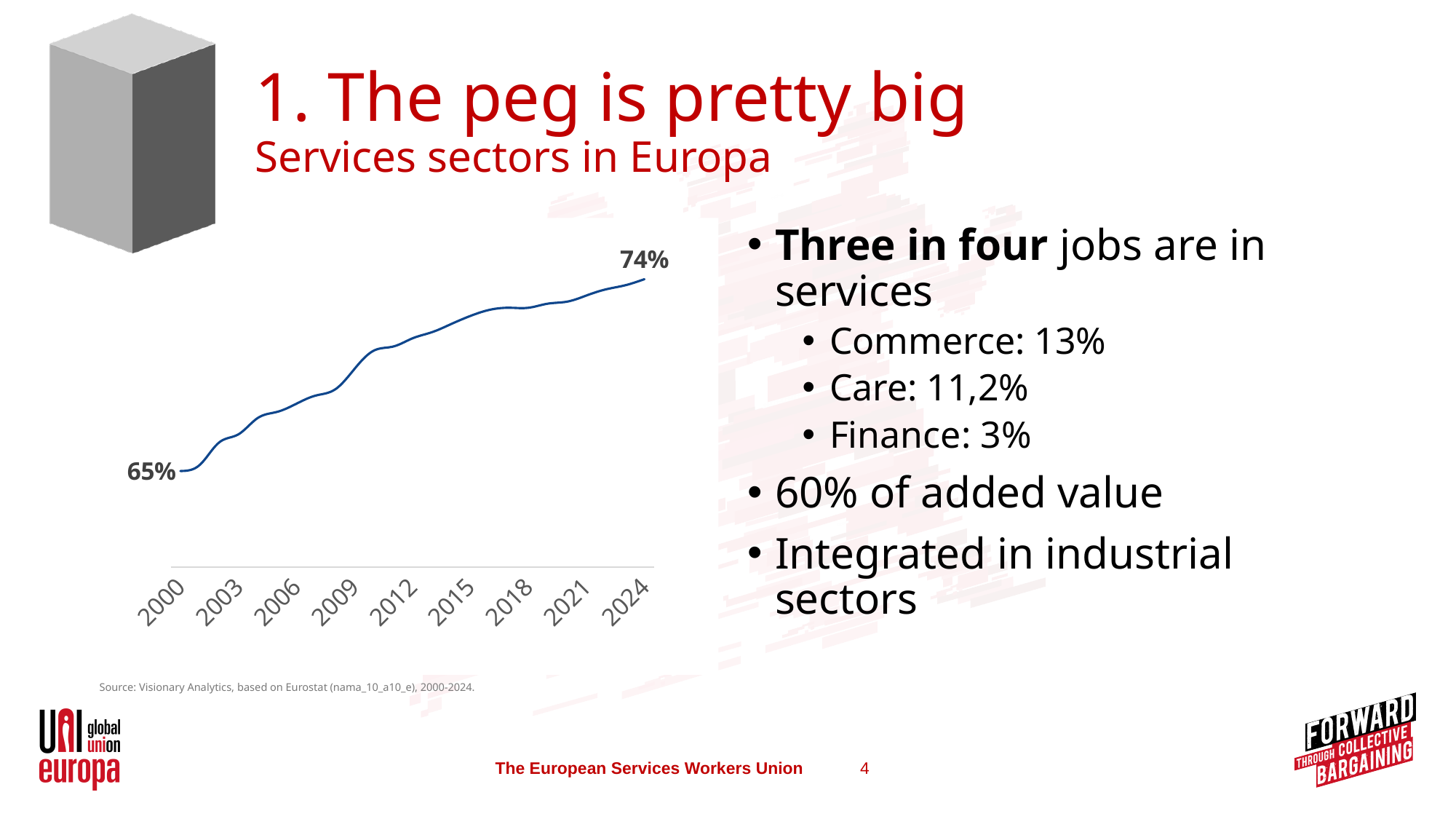
Does the line rise or fall from 2000 to 2024? Rises What colour is the line in the chart? Blue Which year has the larger value, 2000 or 2024? 2024 What is the value shown for 2024 on the line chart? 74% In which year shown on the chart is the value highest? 2024 What is the value shown for 2000 on the line chart? 65% What is the first year labelled on the x axis of the chart? 2000 In which year shown on the chart is the value lowest? 2000 What kind of chart is shown on the slide? Line chart By how many percentage points does the value in 2024 exceed the value in 2000? 9 percentage points How many year labels are shown on the x axis of the chart? 9